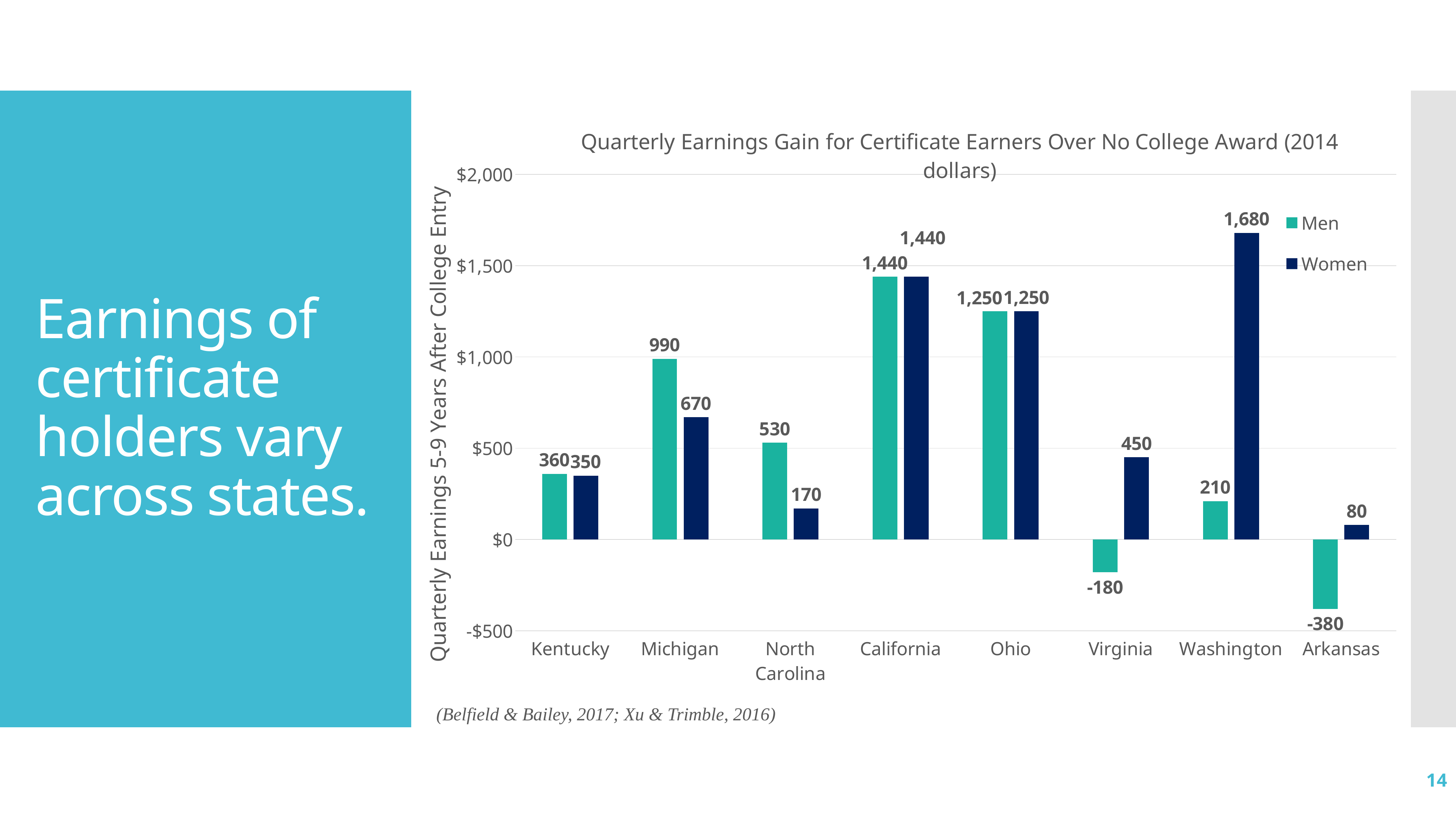
Which state has the highest value for Women? Washington Which is larger in Virginia, the value for Men or for Women? Women How many series does the legend list? 2 What is the difference between the Men and Women values in Michigan? 320 Which state has the lowest value for Men? Arkansas What is the value for Men in Arkansas? -380 How many states are shown on the x axis? 8 What kind of chart is shown on the slide? bar chart What is the value for Women in Washington? 1,680 What is the title of the chart? Quarterly Earnings Gain for Certificate Earners Over No College Award (2014 dollars) Is the value for Men in North Carolina greater or less than $500? greater What is the value for Men in Michigan? 990